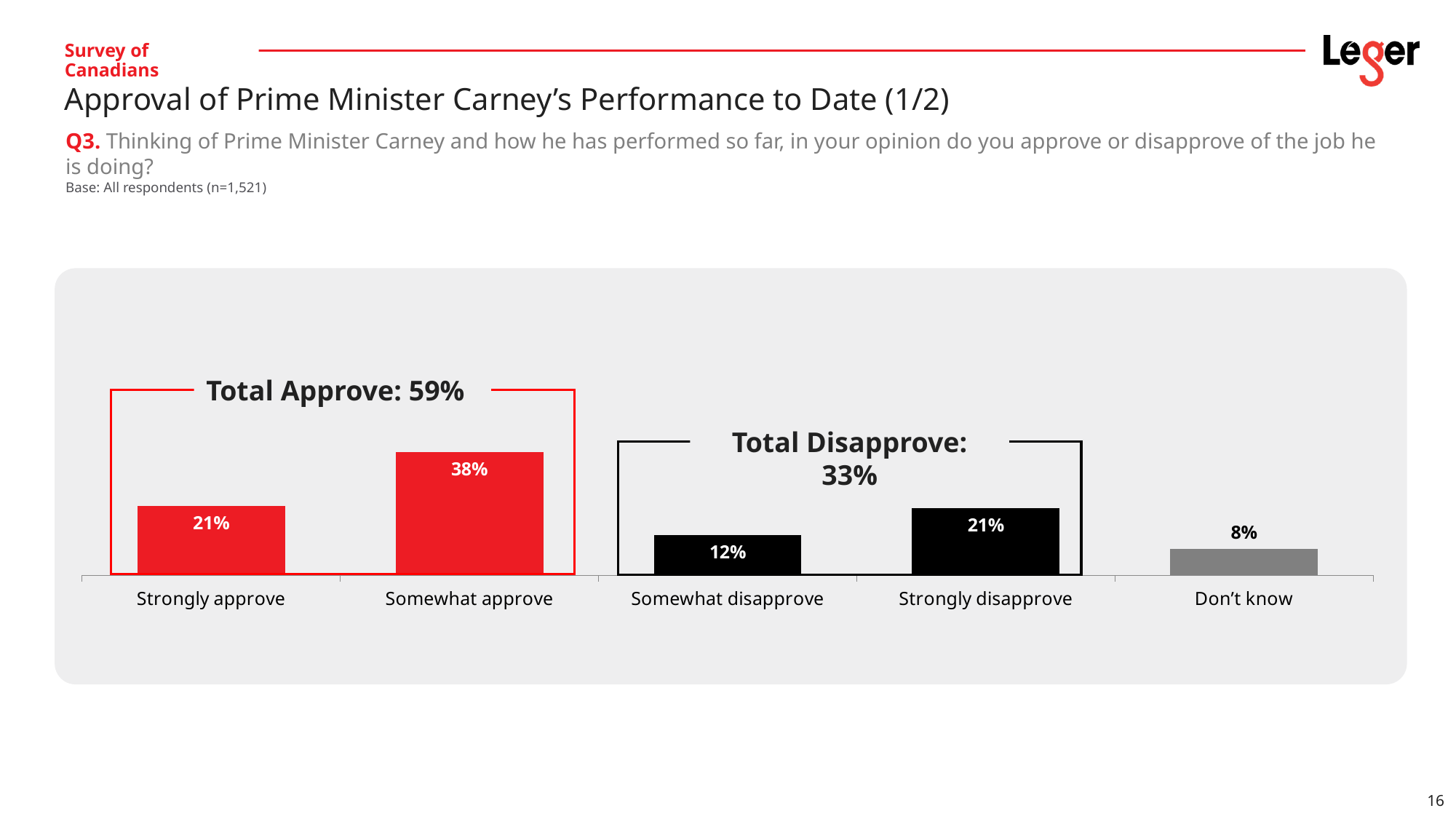
What is the difference between Somewhat approve and Somewhat disapprove? 26% What is the Total Approve figure shown on the chart? 59% What is the value for Don't know? 8% What is the value for Somewhat disapprove? 12% Which category has the lowest value? Don't know What is the Total Disapprove figure shown on the chart? 33% What percentage of respondents somewhat approve? 38% Which category has the highest value? Somewhat approve Which is larger, Strongly disapprove or Somewhat disapprove? Strongly disapprove What percentage of respondents strongly approve of Prime Minister Carney's performance? 21% How many categories are shown on the chart? 5 What kind of chart is shown on the slide? Bar chart